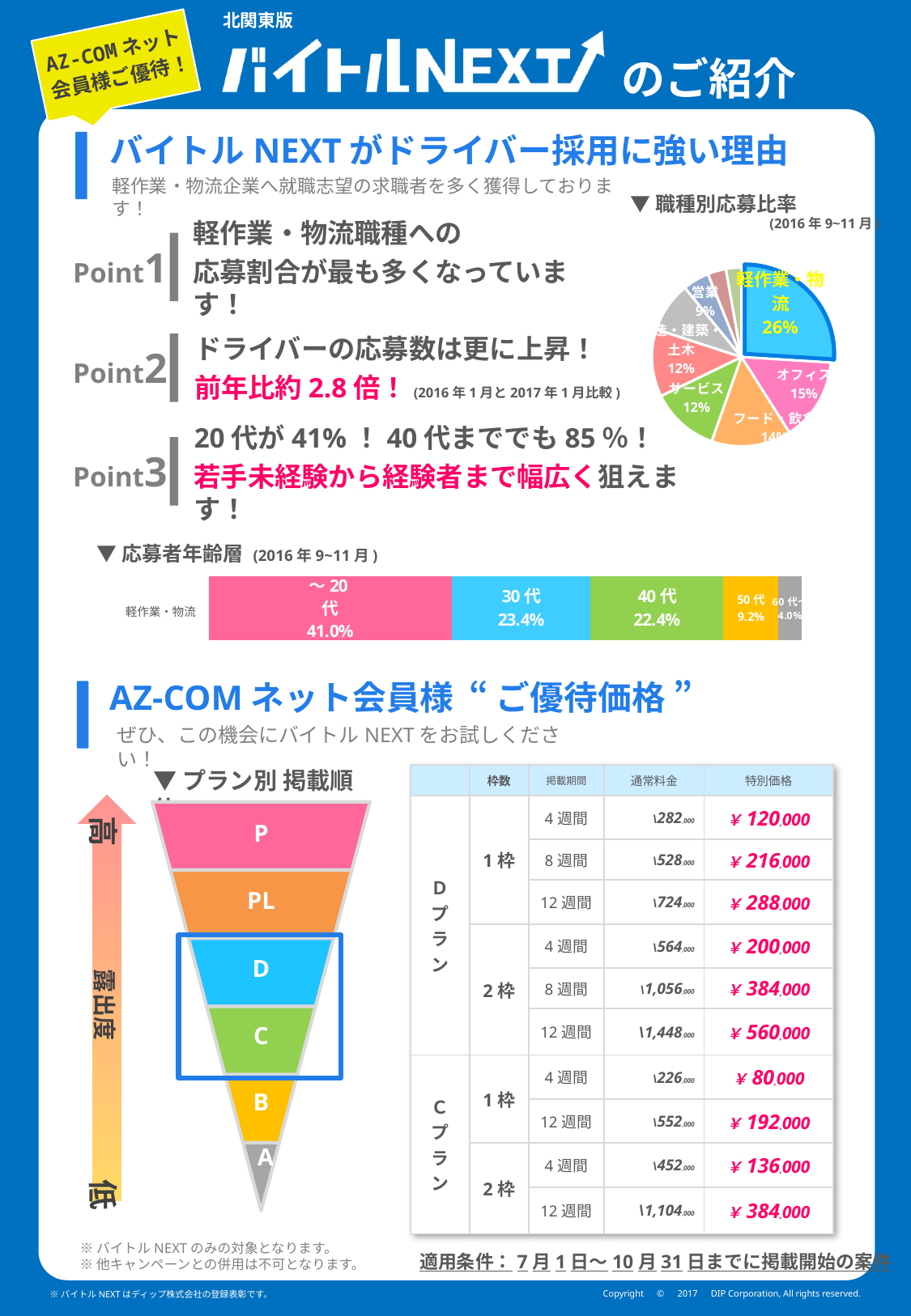
In the 職種別応募比率 pie chart, which category has the largest slice? 軽作業・物流 What kind of chart is the 職種別応募比率 chart? pie chart In the 応募者年齢層 chart, what is the value for 30代? 23.4% In the 応募者年齢層 chart, which age group has the smallest segment? 60代～ In the 職種別応募比率 pie chart, what is the value for 営業? 9% In the 職種別応募比率 pie chart, how many percentage points larger is 軽作業・物流 than オフィス? 11 What kind of chart is the 応募者年齢層 chart? stacked bar chart How many age-group segments are shown in the 応募者年齢層 bar? 5 In the 応募者年齢層 chart, which is larger, 30代 or 40代? 30代 In the 職種別応募比率 pie chart, what share does 軽作業・物流 have? 26% In the 職種別応募比率 pie chart, what is the value for オフィス? 15% In the 応募者年齢層 chart, what is the value for ～20代? 41.0%